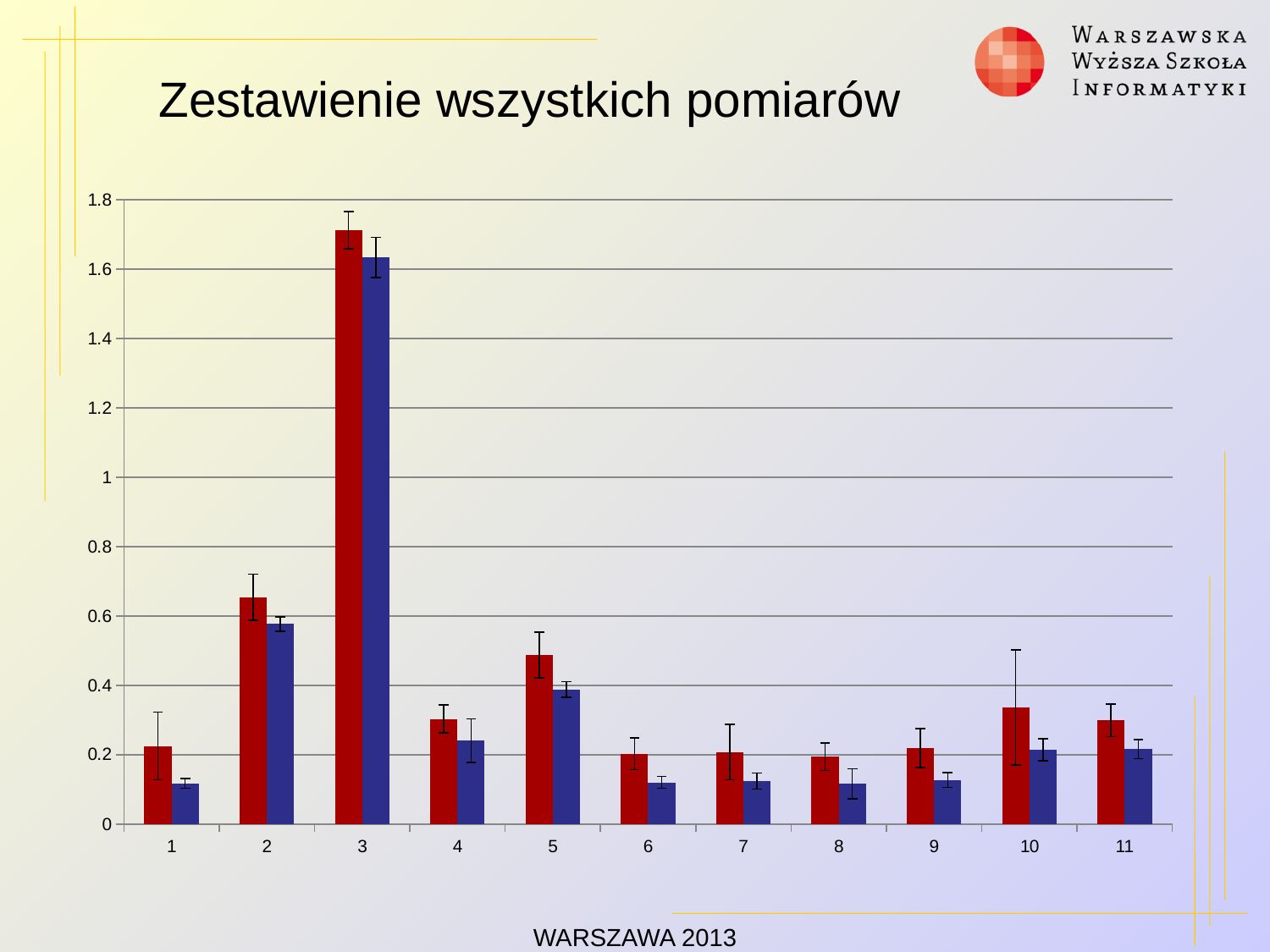
Which category has the highest red bar? 3 What is the title of the chart? Zestawienie wszystkich pomiarów Is the value of the blue bar for category 1 greater or less than 0.2? less What kind of chart is shown on the slide? bar chart For category 3, which bar is taller, the red one or the blue one? red How many data series (bar colours) are plotted in the chart? 2 How many categories are shown on the x axis of the chart? 11 For category 1, which bar is taller, the red one or the blue one? red Is the value of the red bar for category 10 greater or less than 0.2? greater Is the value of the red bar for category 3 greater or less than 1.6? greater Which category has the highest blue bar? 3